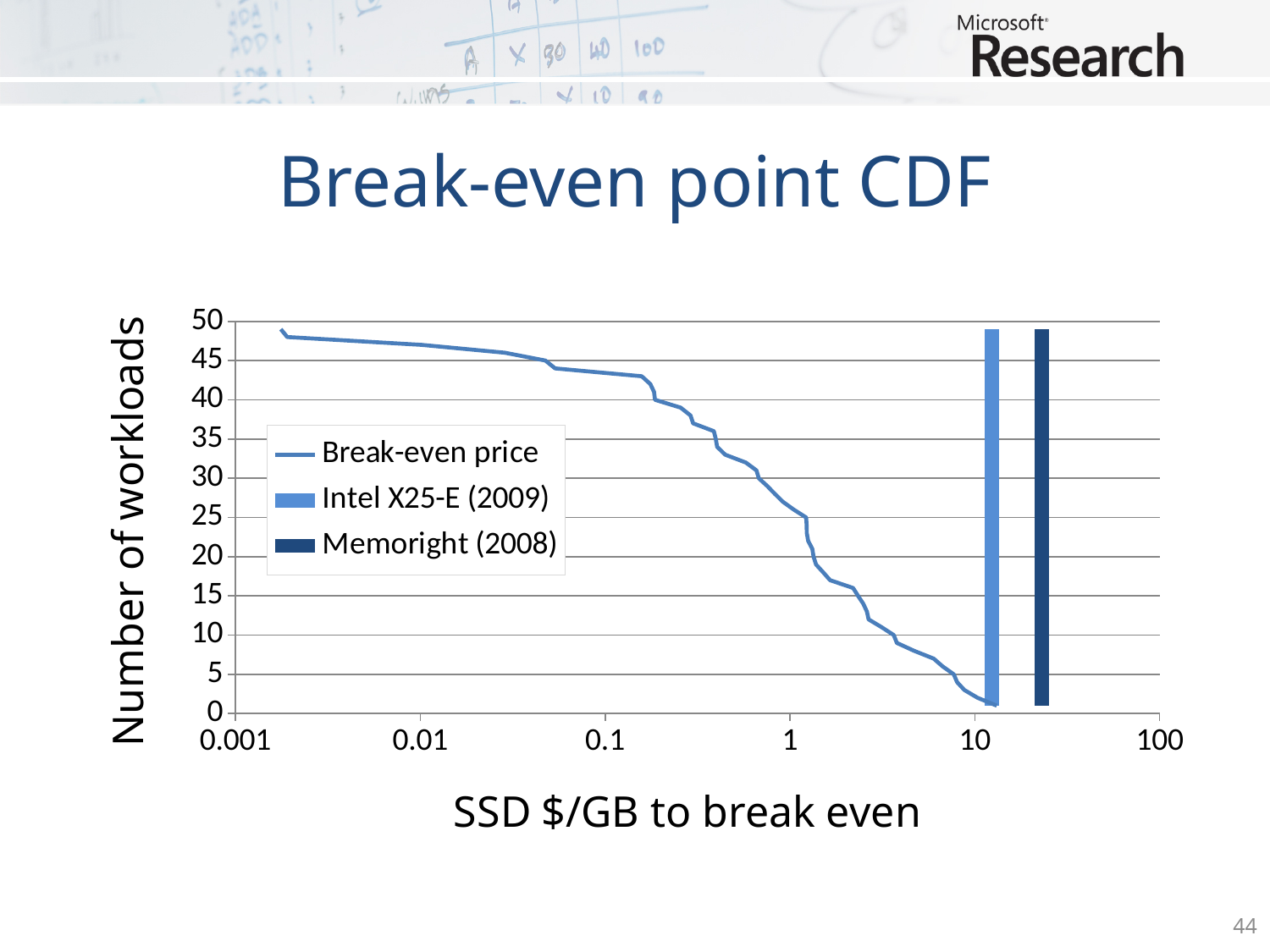
Is the number of workloads on the break-even price line at 10 $/GB greater or less than 5? less What kind of chart is used to show the break-even price? line chart What is the highest value shown on the y axis? 50 Which SSD price marker is further to the right on the x axis, Intel X25-E (2009) or Memoright (2008)? Memoright (2008) What is the label of the x axis? SSD $/GB to break even Is the Intel X25-E (2009) price marker greater or less than 10 $/GB? greater Does the break-even price line rise or fall as the SSD $/GB increases along the x axis? fall How many series does the legend list? 3 Is the number of workloads on the break-even price line at 0.1 $/GB greater or less than 40? greater What is the title of the chart? Break-even point CDF